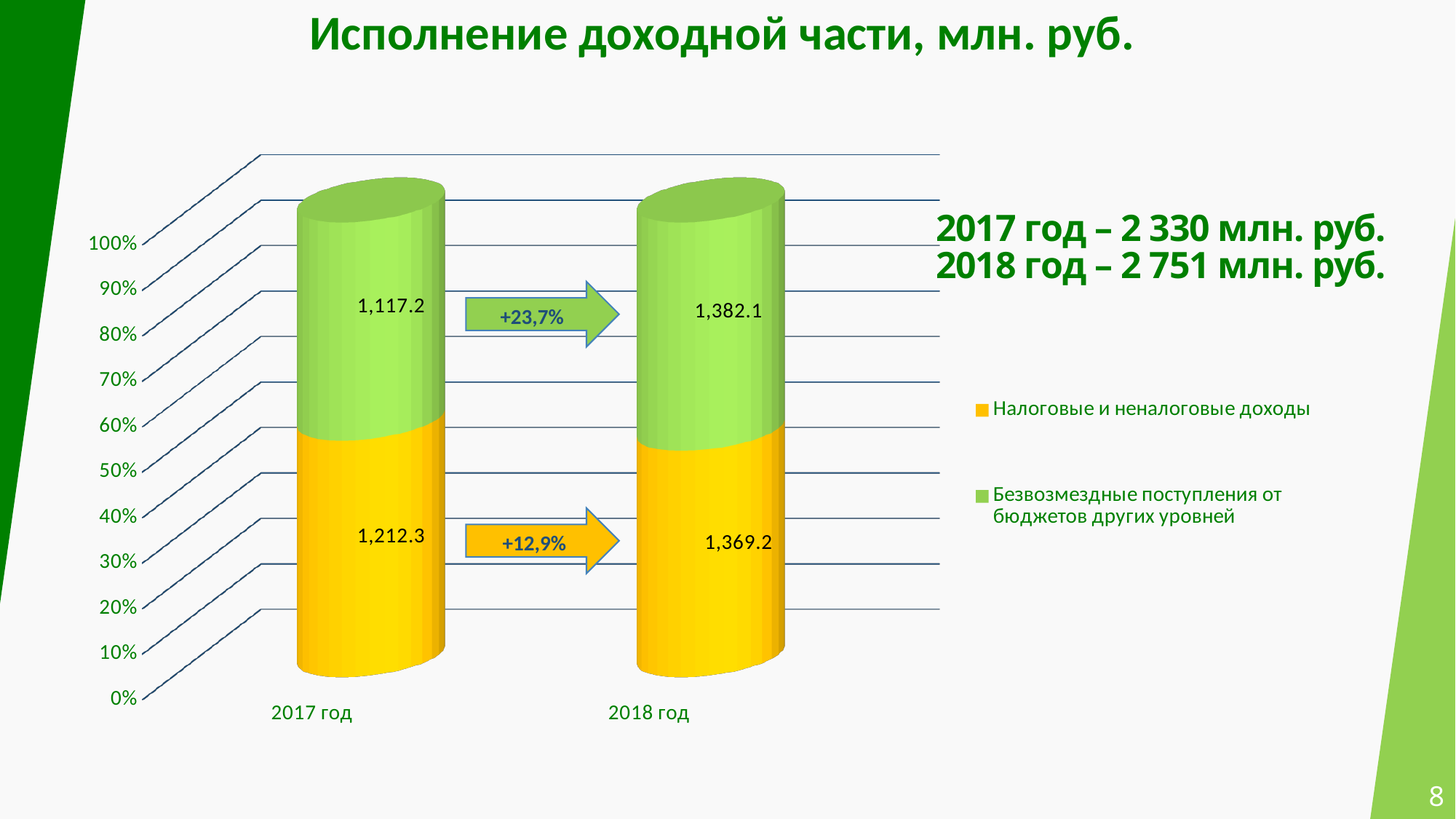
How many series does the legend list? 2 What kind of chart is shown on the slide? Stacked bar chart By how much did Безвозмездные поступления от бюджетов других уровней increase from 2017 год to 2018 год? 264.9 According to the text on the slide, what was the total revenue for 2018 год? 2 751 млн. руб. How many categories are shown on the x axis of the chart? 2 What is the value of Налоговые и неналоговые доходы for 2018 год? 1,369.2 What is the value of Безвозмездные поступления от бюджетов других уровней for 2018 год? 1,382.1 By how much did Налоговые и неналоговые доходы increase from 2017 год to 2018 год? 156.9 What percentage growth is shown by the arrow for Безвозмездные поступления от бюджетов других уровней? +23,7% What is the value of Налоговые и неналоговые доходы for 2017 год? 1,212.3 In 2018 год, which series has the larger value: Налоговые и неналоговые доходы or Безвозмездные поступления от бюджетов других уровней? Безвозмездные поступления от бюджетов других уровней What is the value of Безвозмездные поступления от бюджетов других уровней for 2017 год? 1,117.2